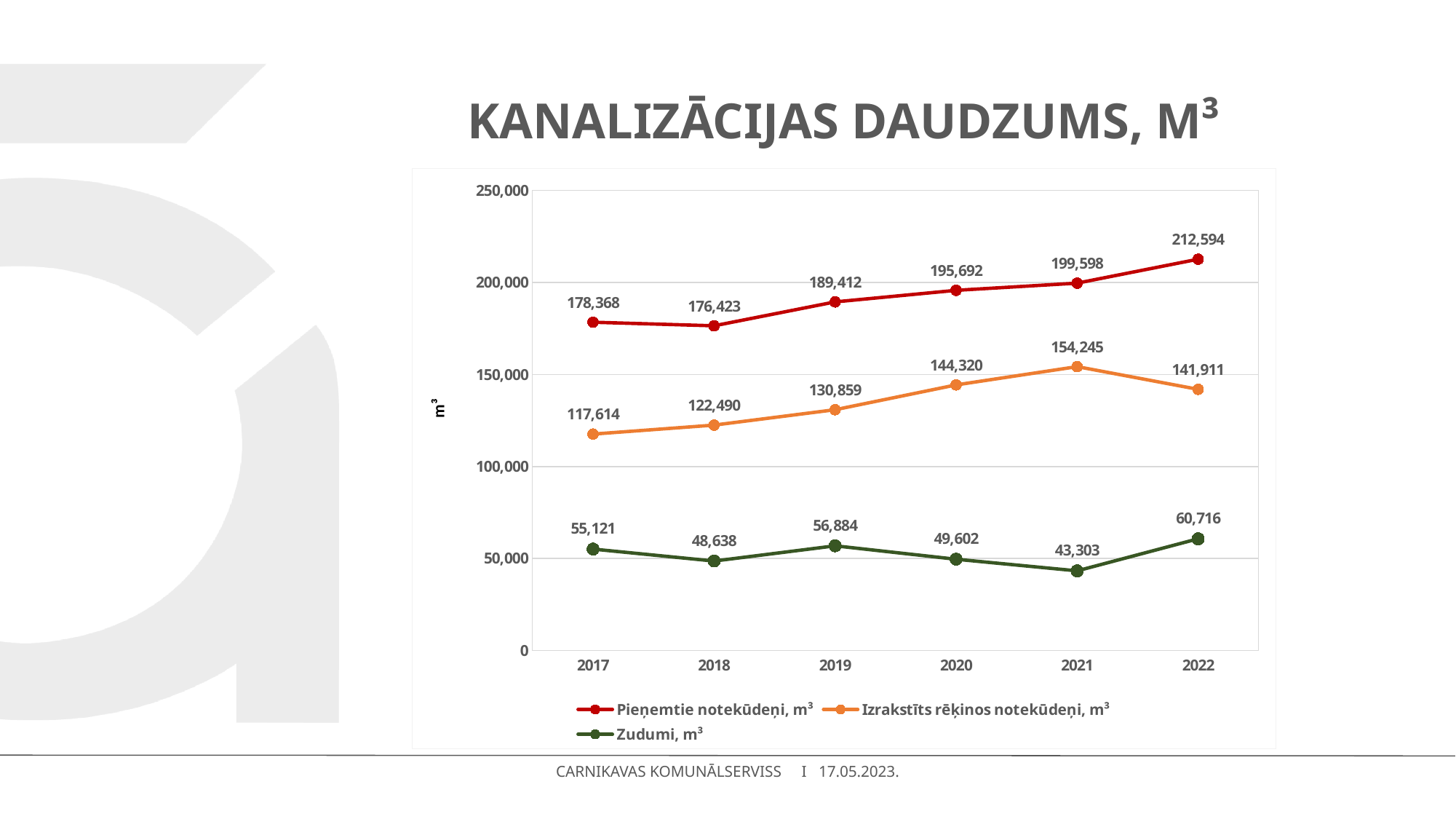
How many series does the legend list? 3 Is the value of Izrakstīts rēķinos notekūdeņi, m³ in 2019 greater or less than 150,000? less Does Pieņemtie notekūdeņi, m³ rise or fall from 2018 to 2022? rise In which year is Pieņemtie notekūdeņi, m³ highest? 2022 What is the difference between Pieņemtie notekūdeņi, m³ and Izrakstīts rēķinos notekūdeņi, m³ in 2022? 70,683 What is the value of Pieņemtie notekūdeņi, m³ in 2019? 189,412 What is the value of Zudumi, m³ in 2018? 48,638 What is the value of Izrakstīts rēķinos notekūdeņi, m³ in 2021? 154,245 In which year is Zudumi, m³ lowest? 2021 What kind of chart is shown on the slide? line chart How many years are shown on the x axis? 6 Which is larger for Izrakstīts rēķinos notekūdeņi, m³: the value in 2020 or in 2022? 2020